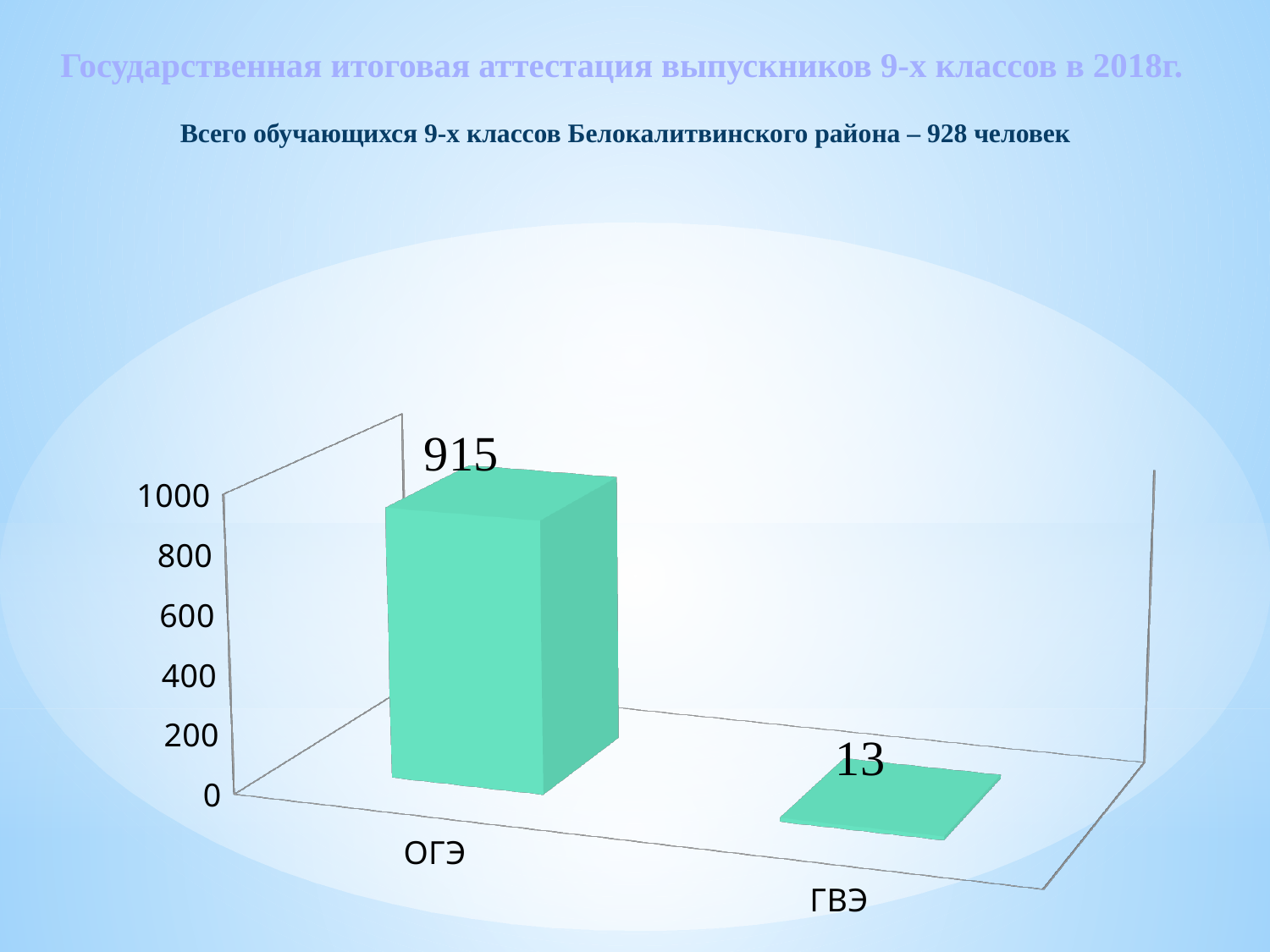
What total number of 9th-grade students is stated in the subtitle above the chart? 928 человек What is the value for ОГЭ? 915 Is the value for ОГЭ greater or less than 800? greater Is the value for ГВЭ greater or less than 200? less How many categories are shown on the chart? 2 Which is larger, the value for ОГЭ or the value for ГВЭ? ОГЭ What is the highest value shown on the vertical axis? 1000 Which category has the lowest value? ГВЭ What kind of chart is shown on the slide? bar chart What is the value for ГВЭ? 13 What is the difference between the values for ОГЭ and ГВЭ? 902 Which category has the highest value? ОГЭ